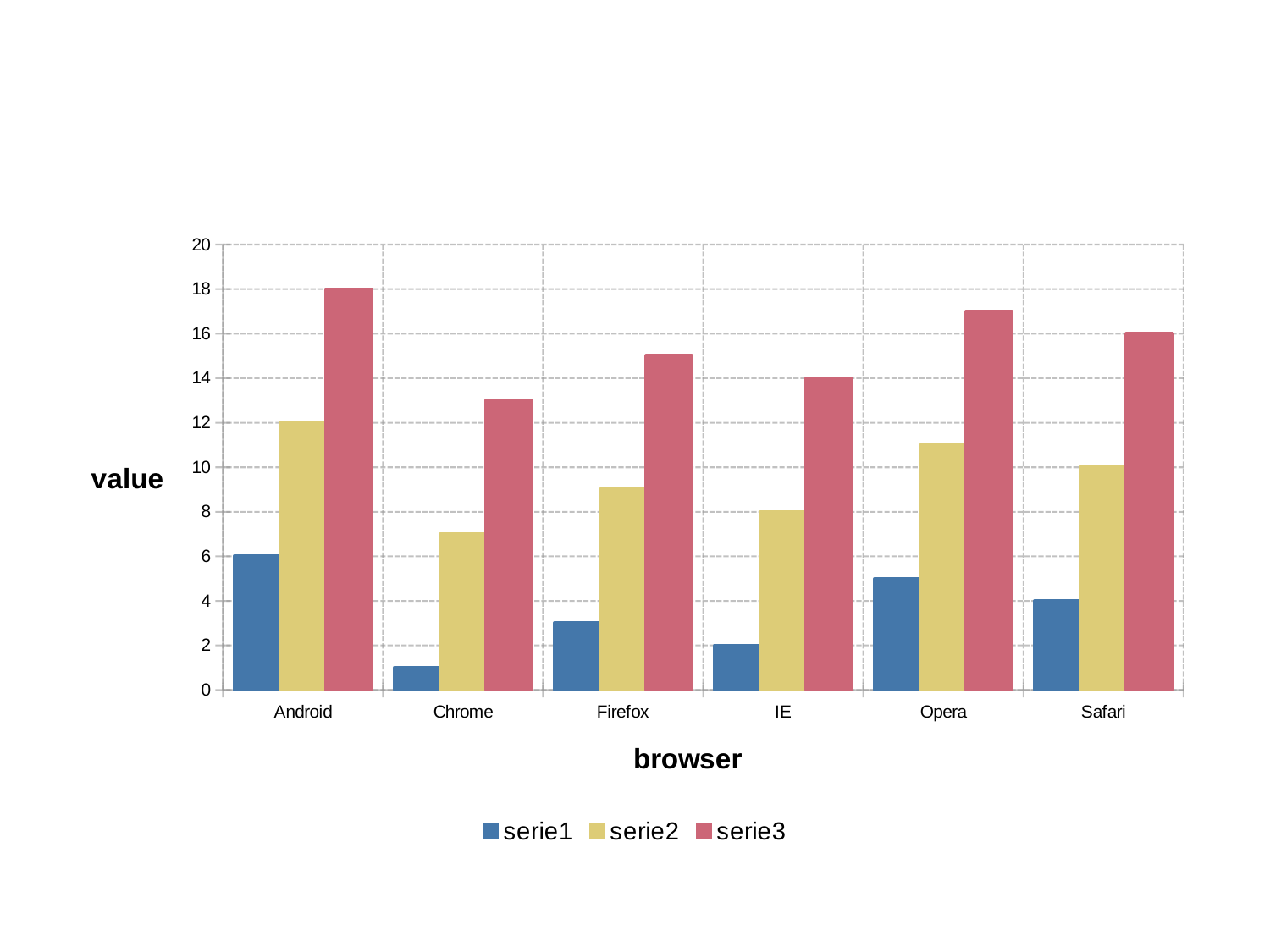
How many browser categories are shown on the x axis? 6 What is the label of the y axis? value How many series does the legend list? 3 Which browser has the lowest serie1 value? Chrome Which browser has the highest serie3 value? Android Which is larger for Firefox: serie2 or serie3? serie3 What kind of chart is shown on the slide? bar chart Is the value of serie2 for Opera greater or less than 10? greater What is the value of serie1 for IE? 2 What is the value of serie3 for Android? 18 What is the value of serie2 for Safari? 10 What is the difference between serie3 and serie1 for Android? 12